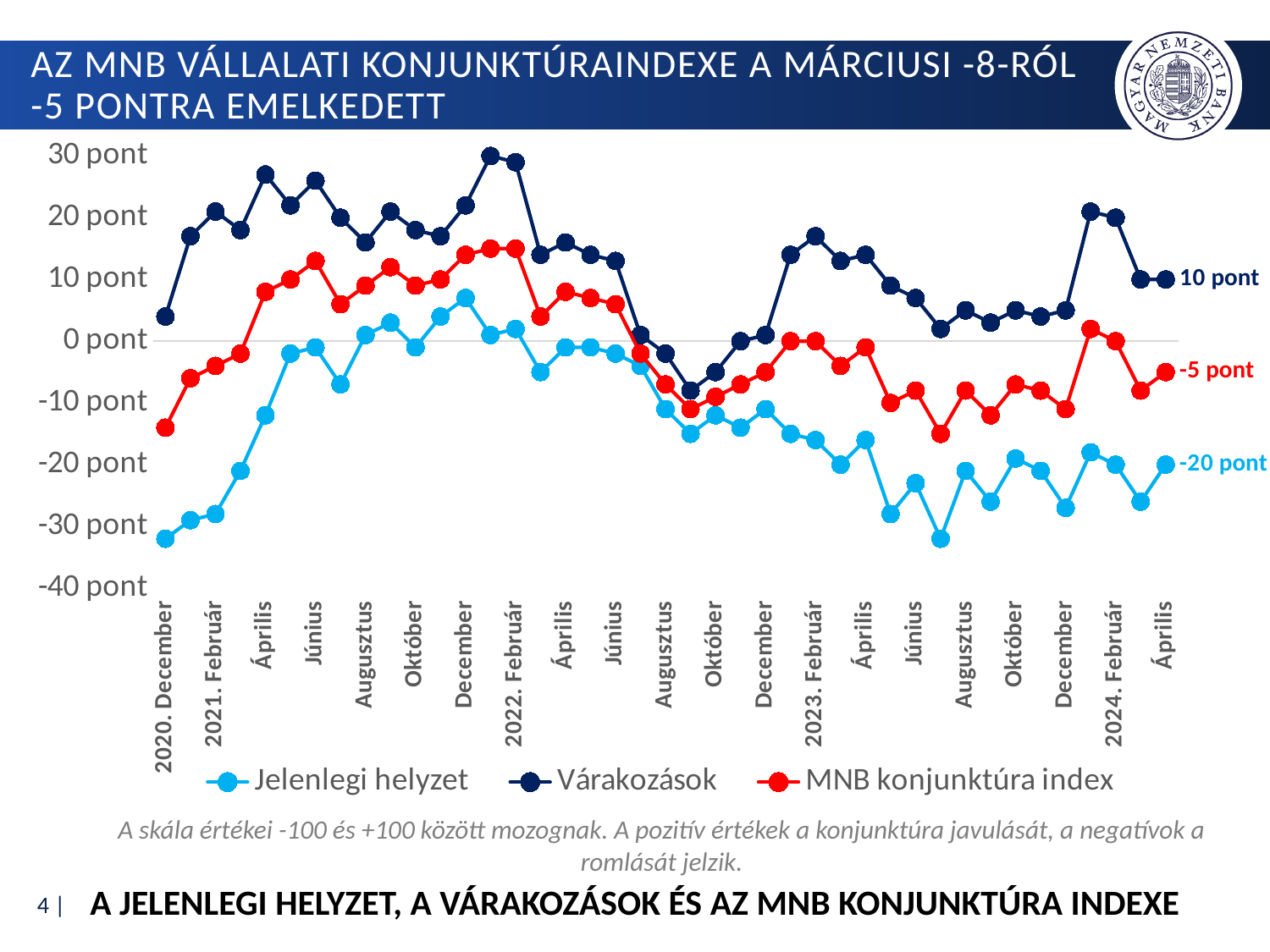
What is the value of the MNB konjunktúra index in 2024 Április? -5 pont Which series has the highest value in 2024 Április? Várakozások What is the difference between Várakozások and the MNB konjunktúra index in 2024 Április? 15 pont Which is larger in 2024 Április, Várakozások or Jelenlegi helyzet? Várakozások What is the difference between the MNB konjunktúra index and Jelenlegi helyzet in 2024 Április? 15 pont Does the Jelenlegi helyzet series rise or fall from 2020 December to 2021 Június? rise How many series does the legend list? 3 What is the value of Jelenlegi helyzet in 2024 Április? -20 pont What kind of chart is shown on the slide? line chart Is the value of Várakozások in 2022 Február greater or less than 20 pont? greater What is the value of Várakozások in 2024 Április? 10 pont Which series is drawn in red? MNB konjunktúra index